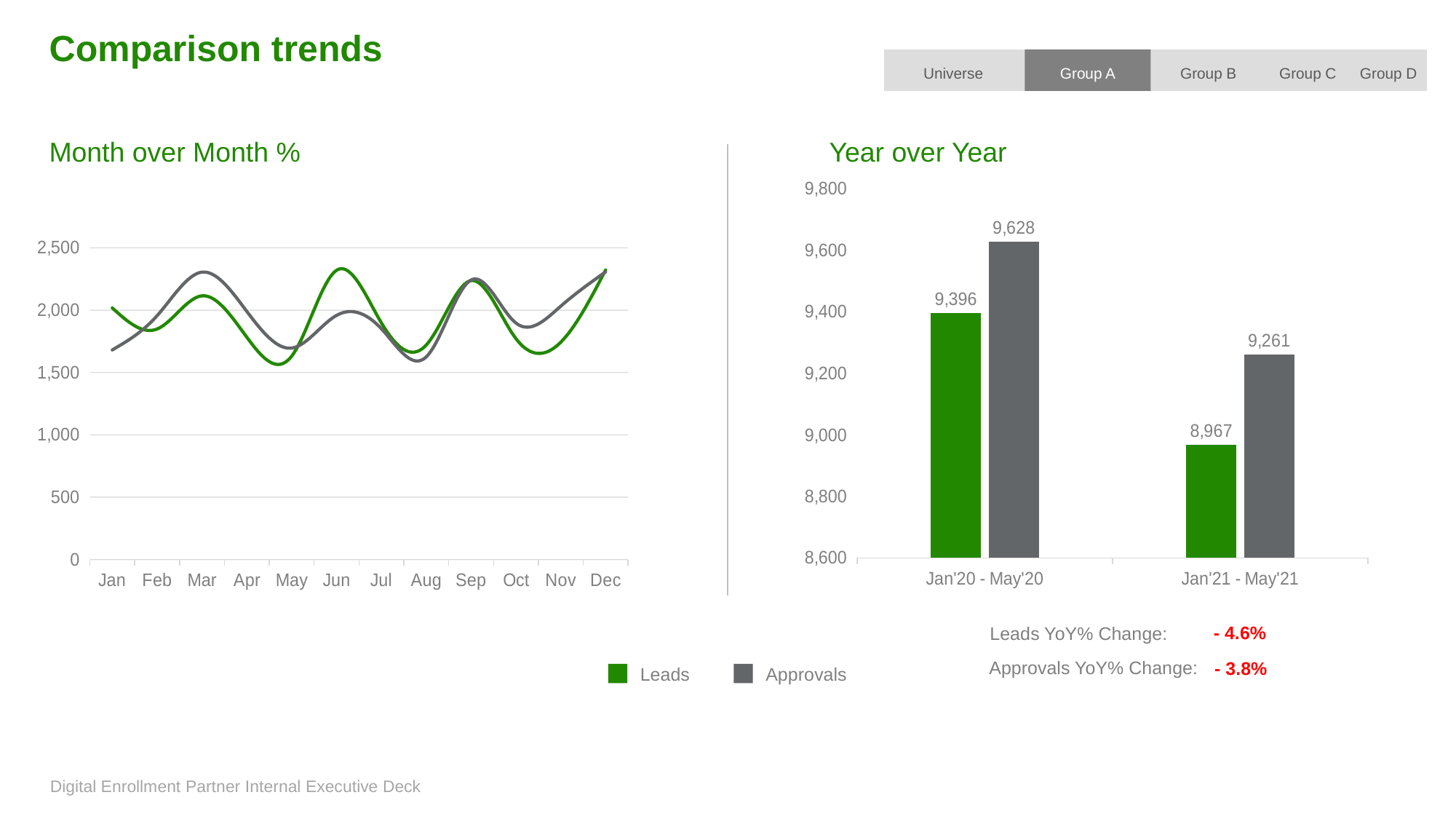
How many series does the legend list? 2 In the Month over Month % chart, is the value for Approvals in Jan greater or less than 2,000? less In the Year over Year chart, which bar has the lowest value? Leads, Jan'21 - May'21 In the Year over Year chart, what is the value for Approvals in Jan'21 - May'21? 9,261 How many months are shown on the x axis of the Month over Month % chart? 12 In the Year over Year chart, what is the difference between Approvals and Leads in Jan'20 - May'20? 232 In the Year over Year chart, which bar has the highest value? Approvals, Jan'20 - May'20 In the Year over Year chart, which is larger: Leads in Jan'21 - May'21 or Approvals in Jan'21 - May'21? Approvals in Jan'21 - May'21 In the Year over Year chart, what is the difference between Leads in Jan'20 - May'20 and Leads in Jan'21 - May'21? 429 What kind of chart is the Year over Year chart? bar chart In the Month over Month % chart, is the value for Leads in Jun greater or less than 2,000? greater In the Year over Year chart, what is the value for Leads in Jan'20 - May'20? 9,396